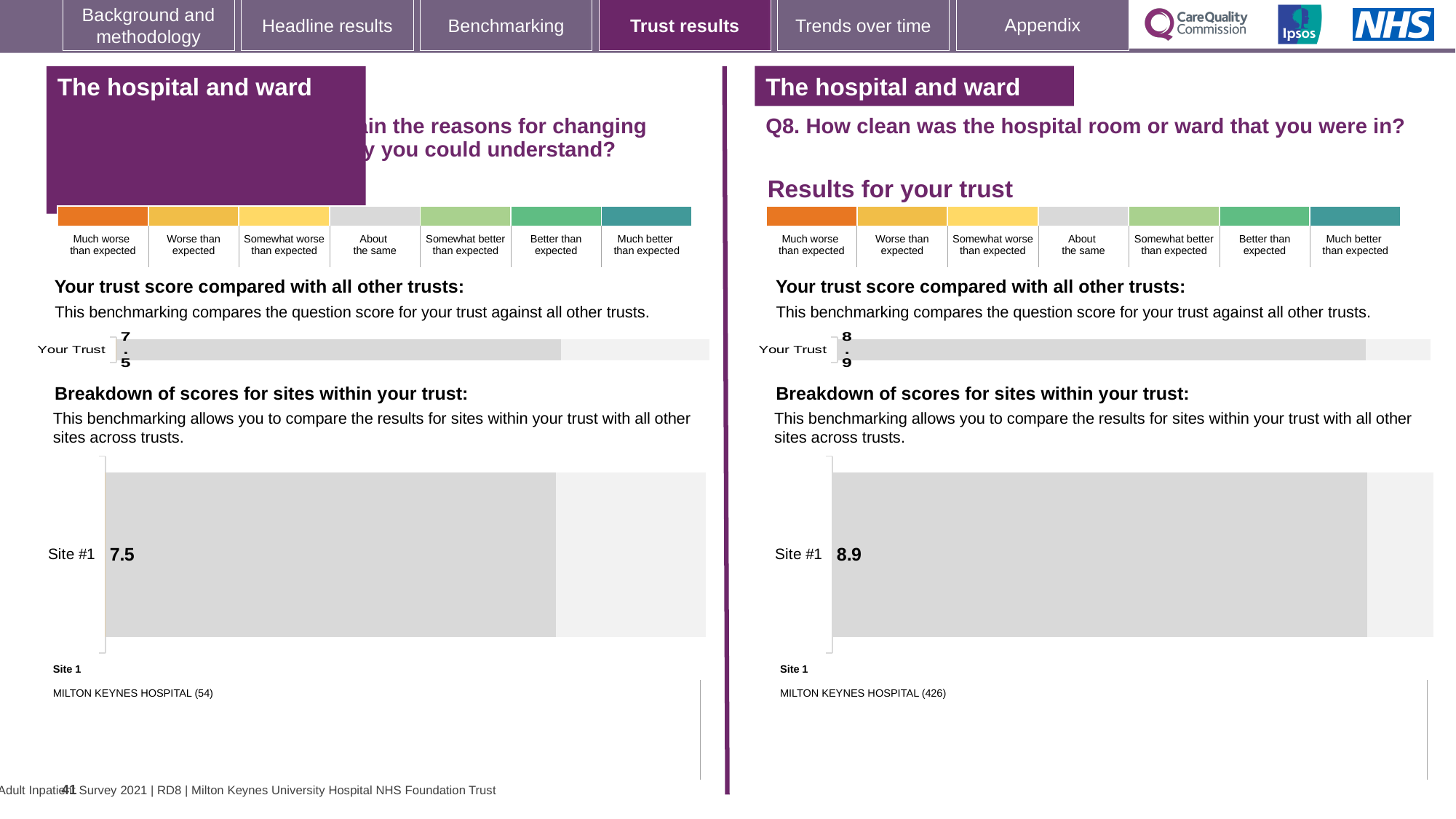
On the left half of the slide, in the 'Your trust score compared with all other trusts' chart, what is the score shown for Your Trust? 7.5 What type of chart is used for the 'Your trust score compared with all other trusts' section on the right half of the slide? Bar chart On the right half of the slide (Q8), which hospital is listed as Site 1 below the site breakdown chart? MILTON KEYNES HOSPITAL On the left half of the slide, in the 'Breakdown of scores for sites within your trust' chart, what is the score for Site #1? 7.5 On the right half of the slide (Q8), in the 'Breakdown of scores for sites within your trust' chart, what is the score for Site #1? 8.9 On the left half of the slide, how many sites are shown in the 'Breakdown of scores for sites within your trust' chart? 1 Which trust score is higher: the one in the left-hand 'Your trust score compared with all other trusts' chart or the one in the right-hand Q8 chart? The right-hand Q8 chart (8.9) On the right half of the slide (Q8, how clean was the hospital room or ward), what is the score shown for Your Trust in the 'Your trust score compared with all other trusts' chart? 8.9 What is the difference between the Your Trust score in the right-hand Q8 chart and the Your Trust score in the left-hand chart? 1.4 On the left half of the slide, what number appears in parentheses after MILTON KEYNES HOSPITAL under the site breakdown chart? 54 On the right half of the slide (Q8), how many sites are shown in the 'Breakdown of scores for sites within your trust' chart? 1